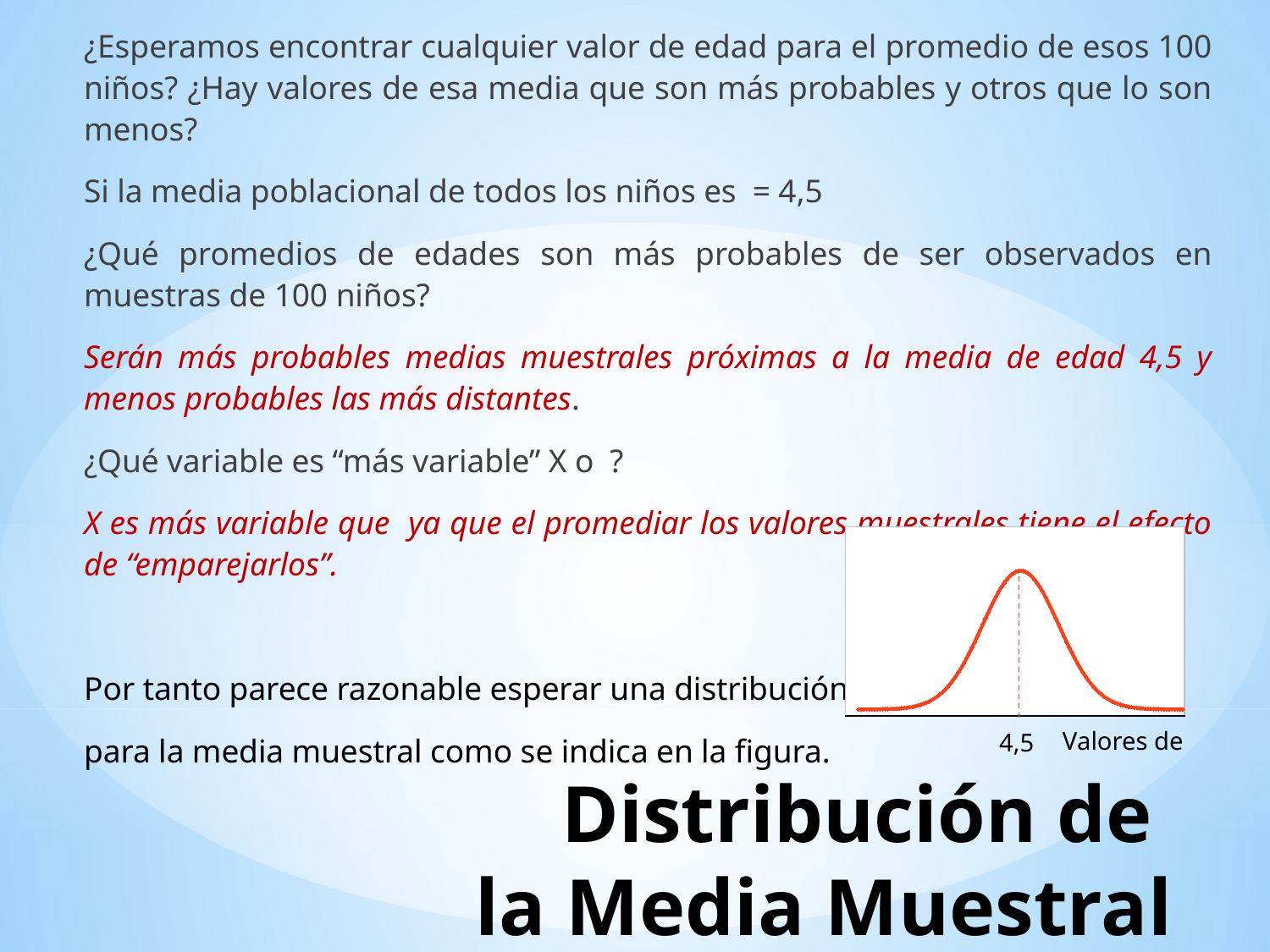
What kind of chart is shown in the figure at the bottom right of the slide? line chart How many curves are plotted in the chart? 1 What is marked by the dashed vertical line in the chart? 4,5 What colour is the curve in the chart? red What is the only value printed on the horizontal axis of the chart? 4,5 Does the curve rise or fall as the horizontal axis moves to the right of 4,5? fall Does the curve rise or fall as the horizontal axis moves from the left edge toward 4,5? rise At which value on the horizontal axis does the curve reach its highest point? 4,5